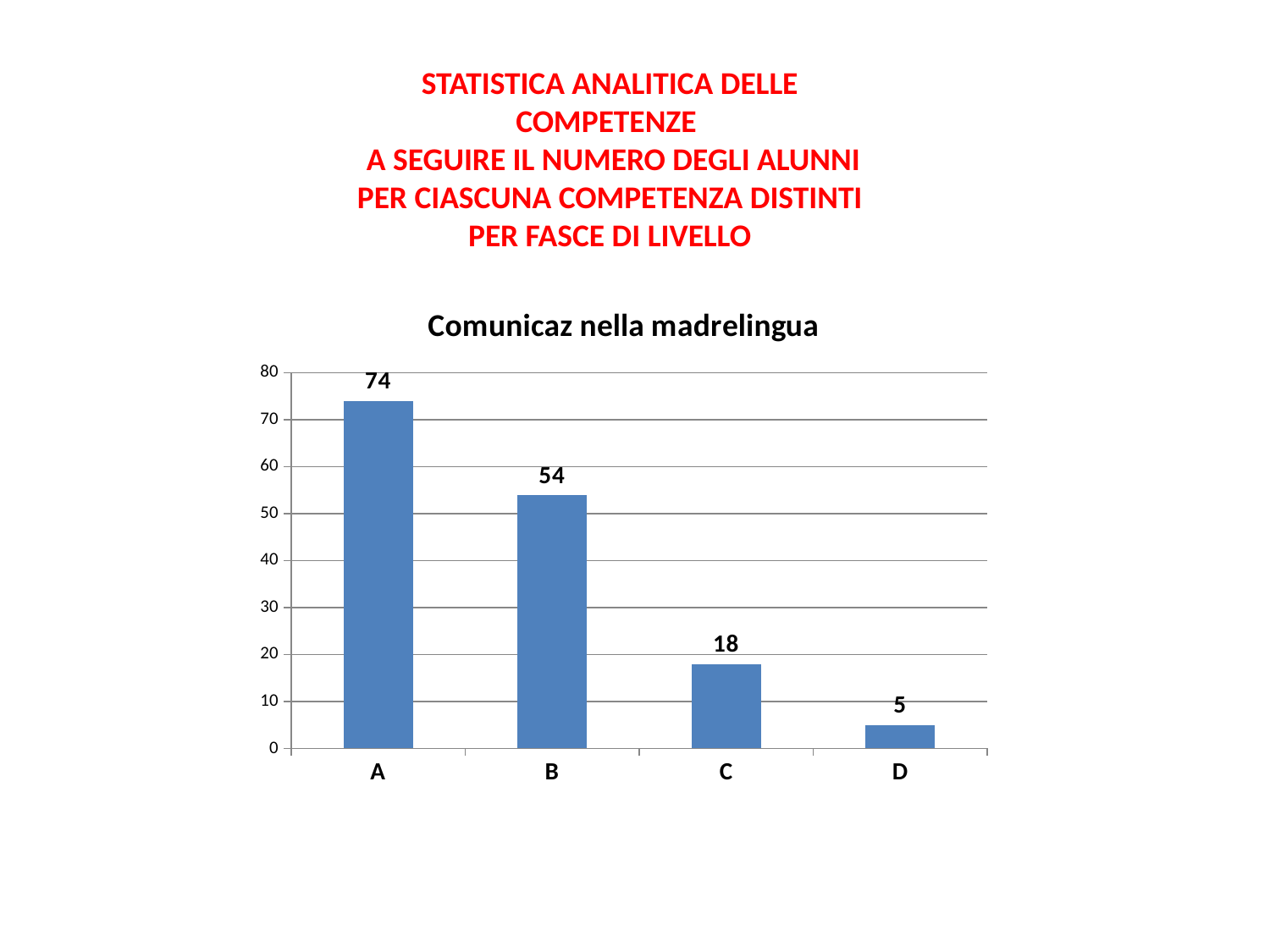
What is the value for category D? 5 Is the value for B greater or less than 50? greater How many categories are shown on the x axis? 4 What is the difference between the values for A and B? 20 What is the value for category B? 54 What is the title of the chart? Comunicaz nella madrelingua Which category has the highest value? A What is the value for category A? 74 Which is larger, the value for C or the value for D? C What is the value for category C? 18 What kind of chart is shown on the slide? Bar chart Which category has the lowest value? D